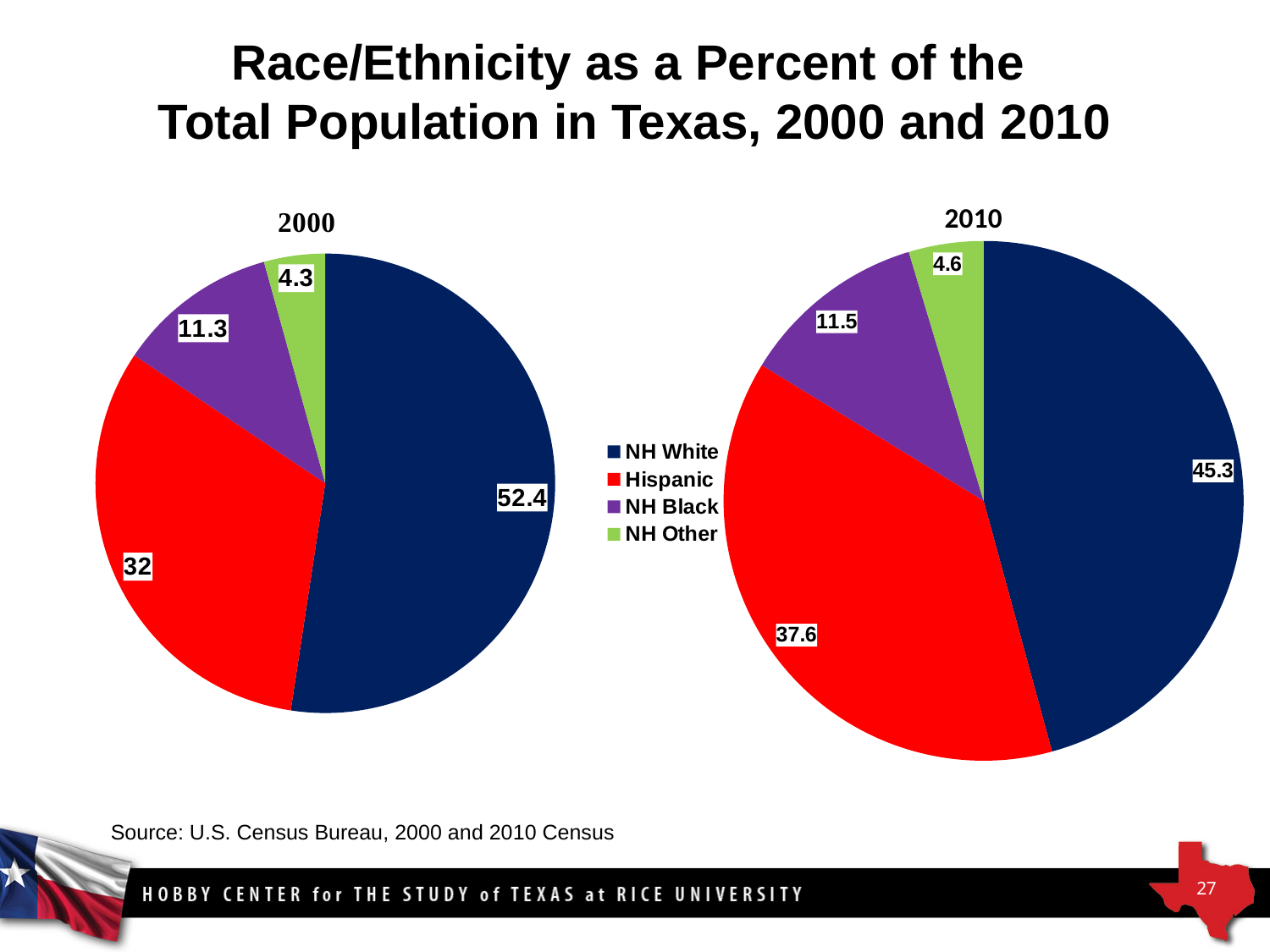
Is the Hispanic value larger in the 2000 pie chart or the 2010 pie chart? 2010 How many categories does each pie chart show? 4 In the 2000 pie chart, what is the value for NH Black? 11.3 In the 2010 pie chart, what is the value for Hispanic? 37.6 In the 2010 pie chart, which category has the largest share? NH White In the 2010 pie chart, what is the difference between the Hispanic and NH Black values? 26.1 What is the difference between the NH White value in the 2000 pie chart and the NH White value in the 2010 pie chart? 7.1 Which colour represents Hispanic in the legend? Red In the 2000 pie chart, which category has the smallest share? NH Other In the 2010 pie chart, what is the value for NH Other? 4.6 What kind of chart is used on this slide? Pie chart In the 2000 pie chart, what is the value for NH White? 52.4